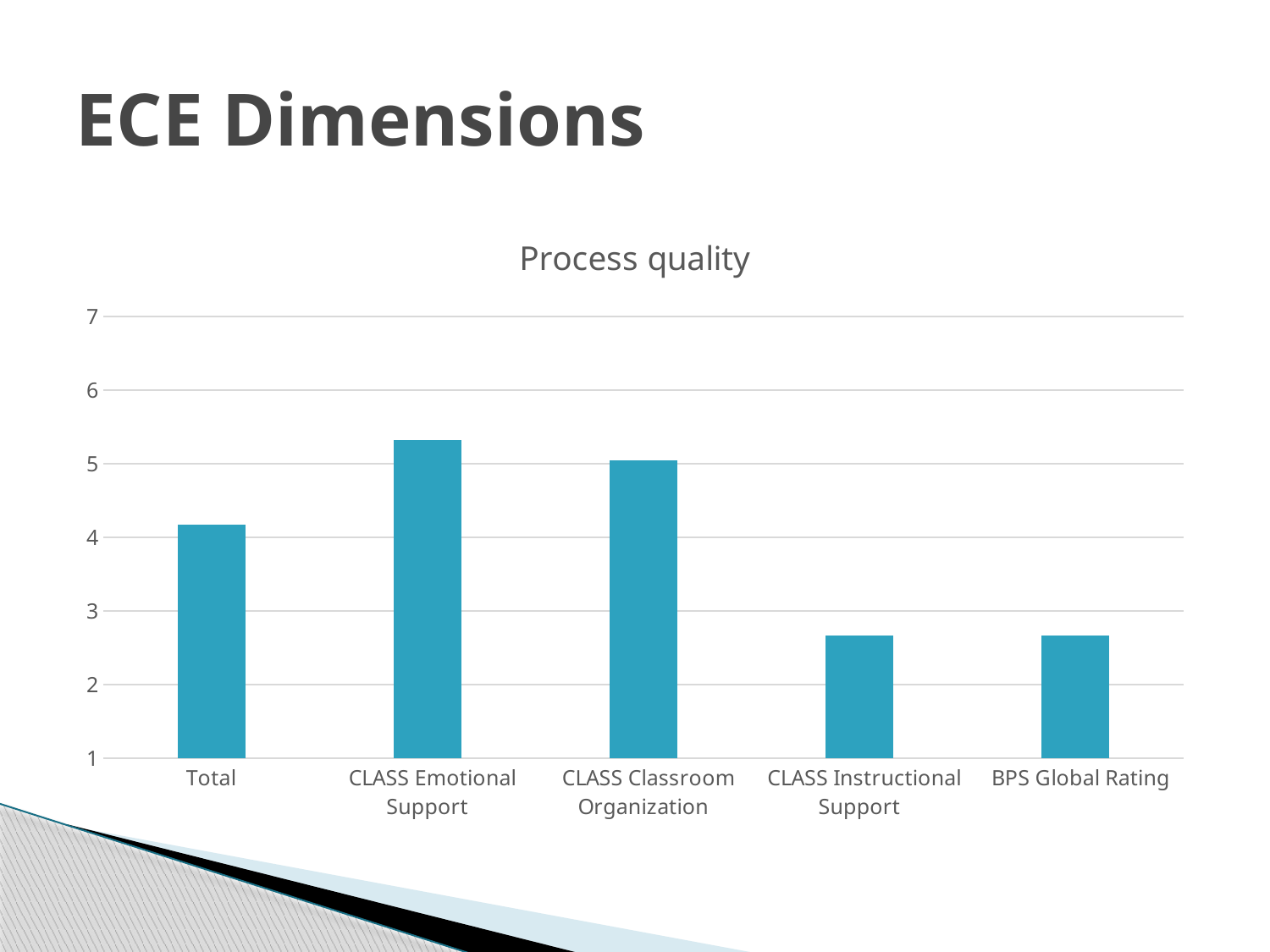
Is the value for Total greater or less than 4? greater How many categories are plotted in the chart? 5 What kind of chart is shown on the slide? bar chart Which category has the highest value in the chart? CLASS Emotional Support Is the value for CLASS Instructional Support greater or less than 3? less Which is larger, the value for Total or the value for CLASS Emotional Support? CLASS Emotional Support Is the value for BPS Global Rating greater or less than 3? less Which is larger, the value for CLASS Classroom Organization or the value for CLASS Instructional Support? CLASS Classroom Organization What is the lowest value shown on the vertical axis of the chart? 1 What is the title of the chart? Process quality